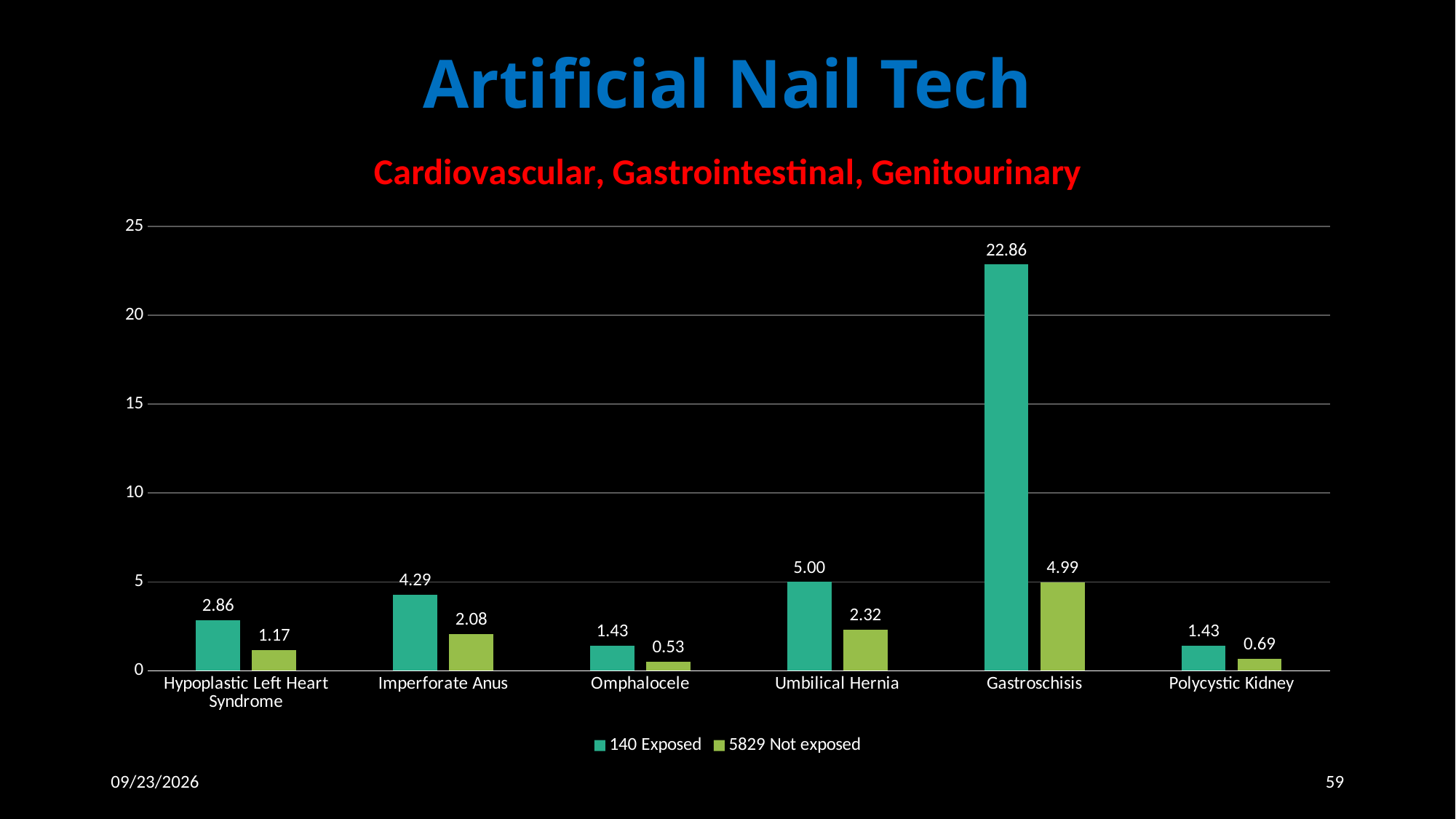
How many categories are shown on the x axis? 6 What is the value for Umbilical Hernia in the 5829 Not exposed series? 2.32 What kind of chart is shown on the slide? Bar chart What is the value for Gastroschisis in the 140 Exposed series? 22.86 Is the 140 Exposed value for Gastroschisis greater or less than 20? greater What is the difference between the 140 Exposed and 5829 Not exposed values for Gastroschisis? 17.87 What is the value for Omphalocele in the 5829 Not exposed series? 0.53 What is the chart's title? Cardiovascular, Gastrointestinal, Genitourinary Which is larger for Imperforate Anus: the 140 Exposed value or the 5829 Not exposed value? 140 Exposed Which category has the lowest value in the 5829 Not exposed series? Omphalocele How many series does the legend list? 2 Which category has the highest value in the 140 Exposed series? Gastroschisis